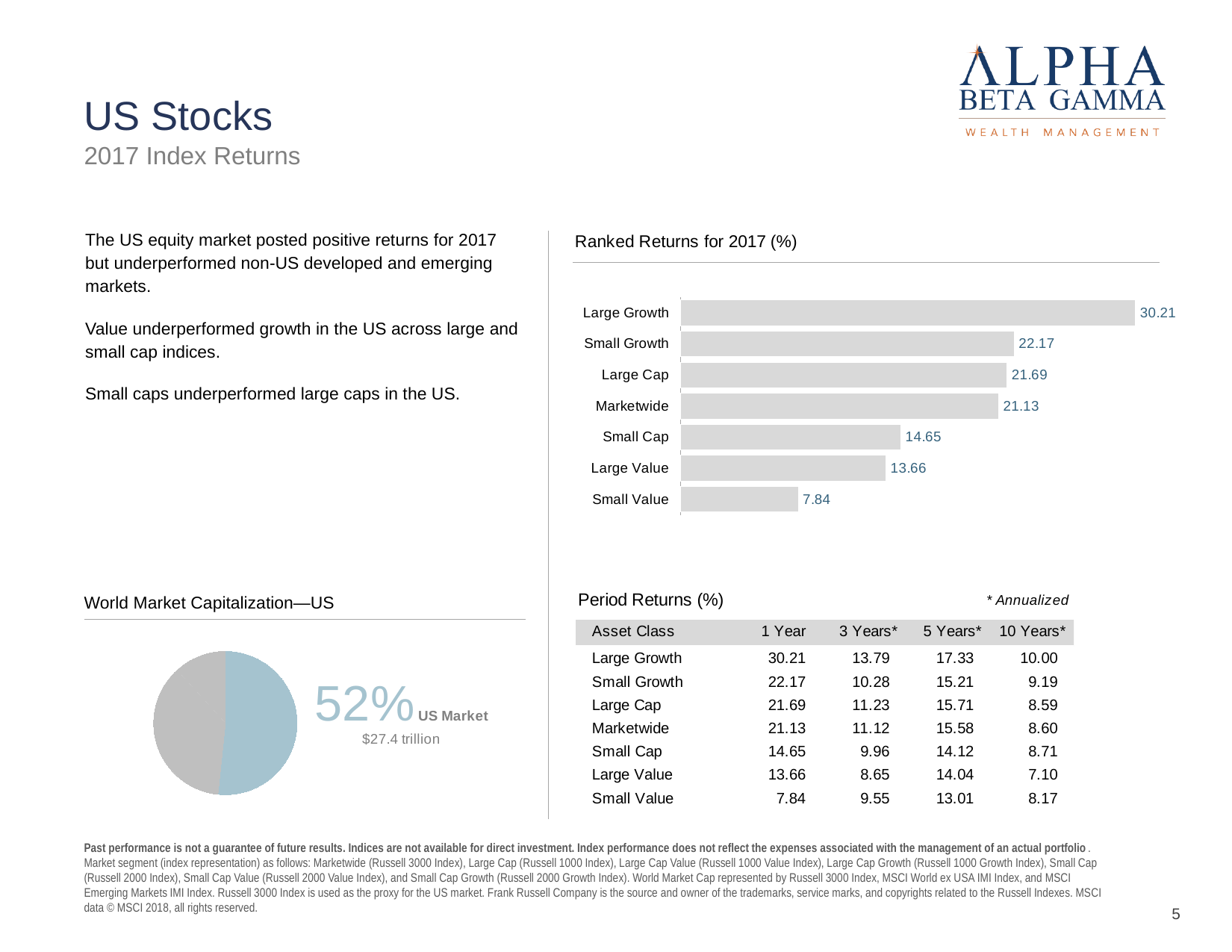
How many categories are shown in the Ranked Returns for 2017 (%) chart? 7 What kind of chart is the World Market Capitalization—US chart? Pie chart In the Ranked Returns for 2017 (%) chart, what is the value for Large Growth? 30.21 What kind of chart is the Ranked Returns for 2017 (%) chart? Bar chart In the Ranked Returns for 2017 (%) chart, which category has the lowest value? Small Value In the World Market Capitalization—US pie chart, what share does the US Market slice represent? 52% In the Ranked Returns for 2017 (%) chart, what is the difference between Small Cap and Large Value? 0.99 In the Ranked Returns for 2017 (%) chart, what is the value for Marketwide? 21.13 In the Ranked Returns for 2017 (%) chart, which category has the highest value? Large Growth In the Ranked Returns for 2017 (%) chart, which is larger, Large Cap or Small Cap? Large Cap In the Ranked Returns for 2017 (%) chart, what is the value for Small Value? 7.84 In the Ranked Returns for 2017 (%) chart, what is the difference between Large Growth and Small Growth? 8.04